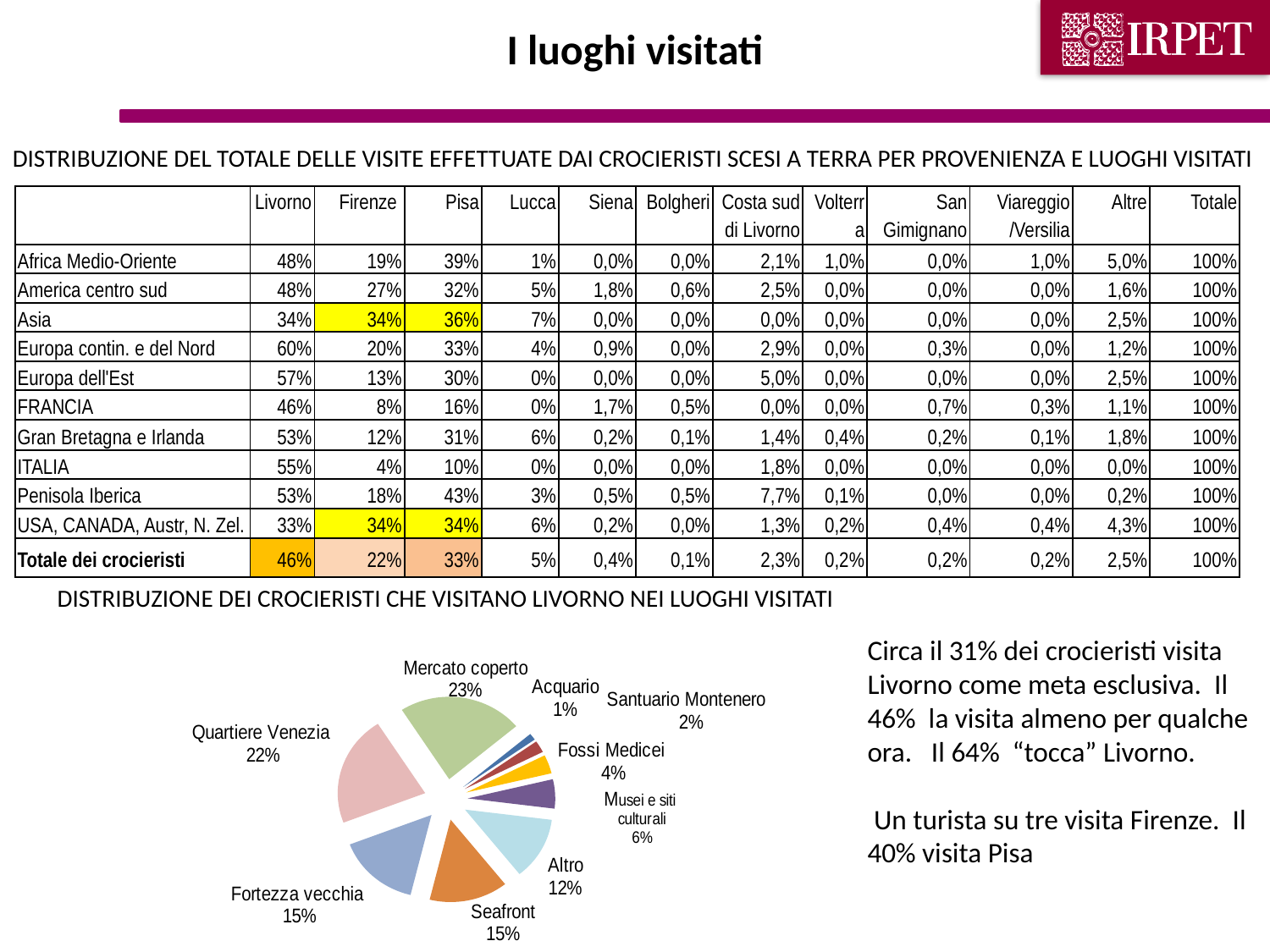
Which slice of the pie chart is the smallest? Acquario What type of chart is shown on the slide? Pie chart What is the value for Altro in the pie chart? 12% Which slice of the pie chart is the largest? Mercato coperto What is the value for Musei e siti culturali in the pie chart? 6% What share of the pie chart does Mercato coperto have? 23% What is the title printed above the pie chart? DISTRIBUZIONE DEI CROCIERISTI CHE VISITANO LIVORNO NEI LUOGHI VISITATI What share of the pie chart does Quartiere Venezia have? 22% What is the difference between the shares of Mercato coperto and Fortezza vecchia in the pie chart? 8% What is the combined share of Seafront and Fortezza vecchia in the pie chart? 30% Which is larger in the pie chart, Fossi Medicei or Santuario Montenero? Fossi Medicei How many slices does the pie chart have? 9